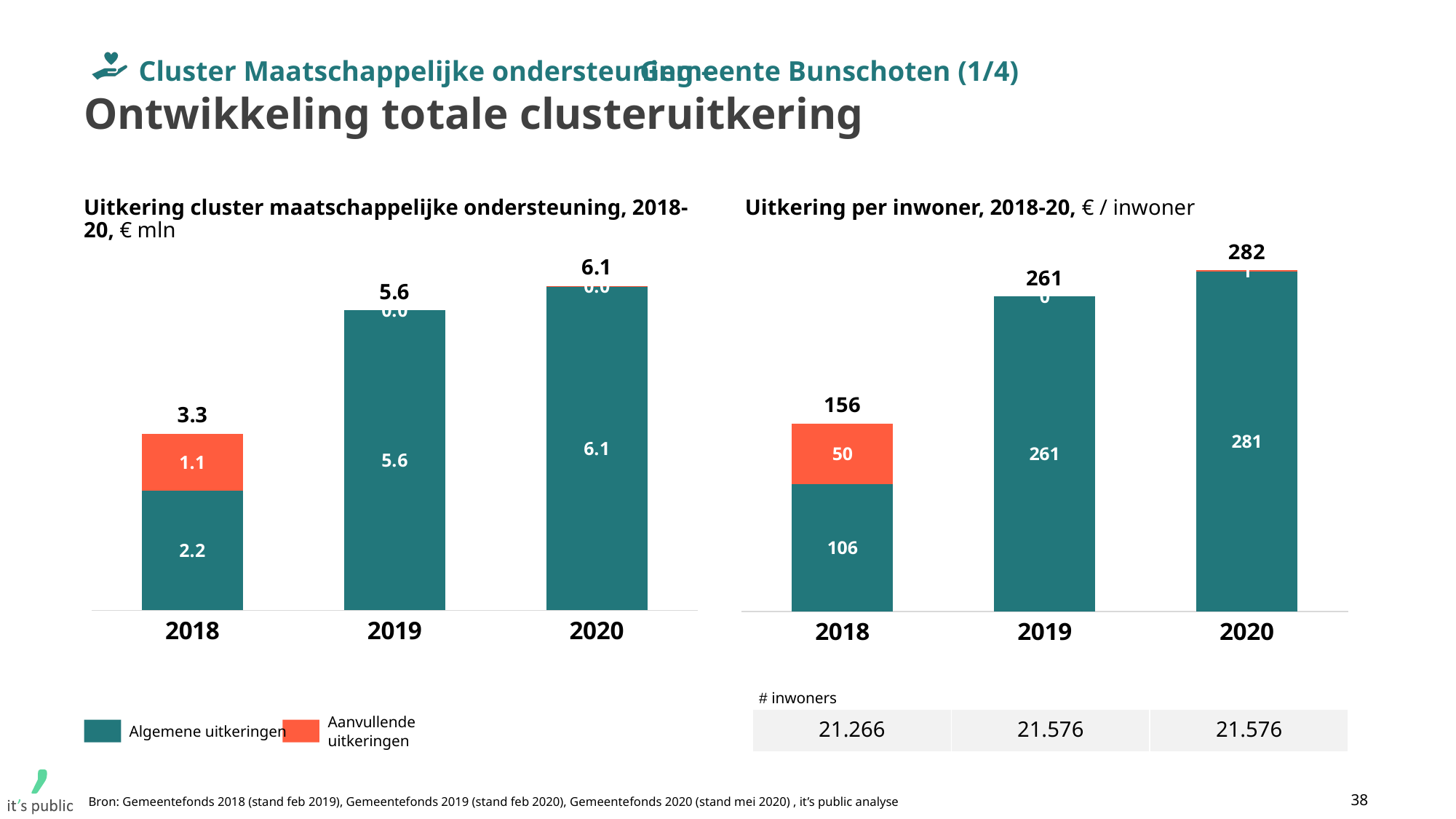
In the left chart (Uitkering cluster maatschappelijke ondersteuning), what is the difference between the 2020 total and the 2018 total? 2.8 In the left chart (Uitkering cluster maatschappelijke ondersteuning), which year has the highest total? 2020 In the left chart (Uitkering cluster maatschappelijke ondersteuning), what is the total of the stacked bar for 2019? 5.6 In the right chart (Uitkering per inwoner), do the totals rise or fall from 2018 to 2020? rise In the right chart (Uitkering per inwoner), what is the value of Algemene uitkeringen for 2020? 281 In the right chart (Uitkering per inwoner), what is the difference between the 2019 total and the 2018 total? 105 In the left chart (Uitkering cluster maatschappelijke ondersteuning), what is the value of Algemene uitkeringen for 2018? 2.2 In the right chart (Uitkering per inwoner), which year has the lowest total? 2018 In the left chart (Uitkering cluster maatschappelijke ondersteuning), what is the value of Aanvullende uitkeringen for 2018? 1.1 In the right chart (Uitkering per inwoner), what is the value of Aanvullende uitkeringen for 2018? 50 How many series does the legend on the slide list? 2 In the right chart (Uitkering per inwoner), what is the total of the stacked bar for 2018? 156